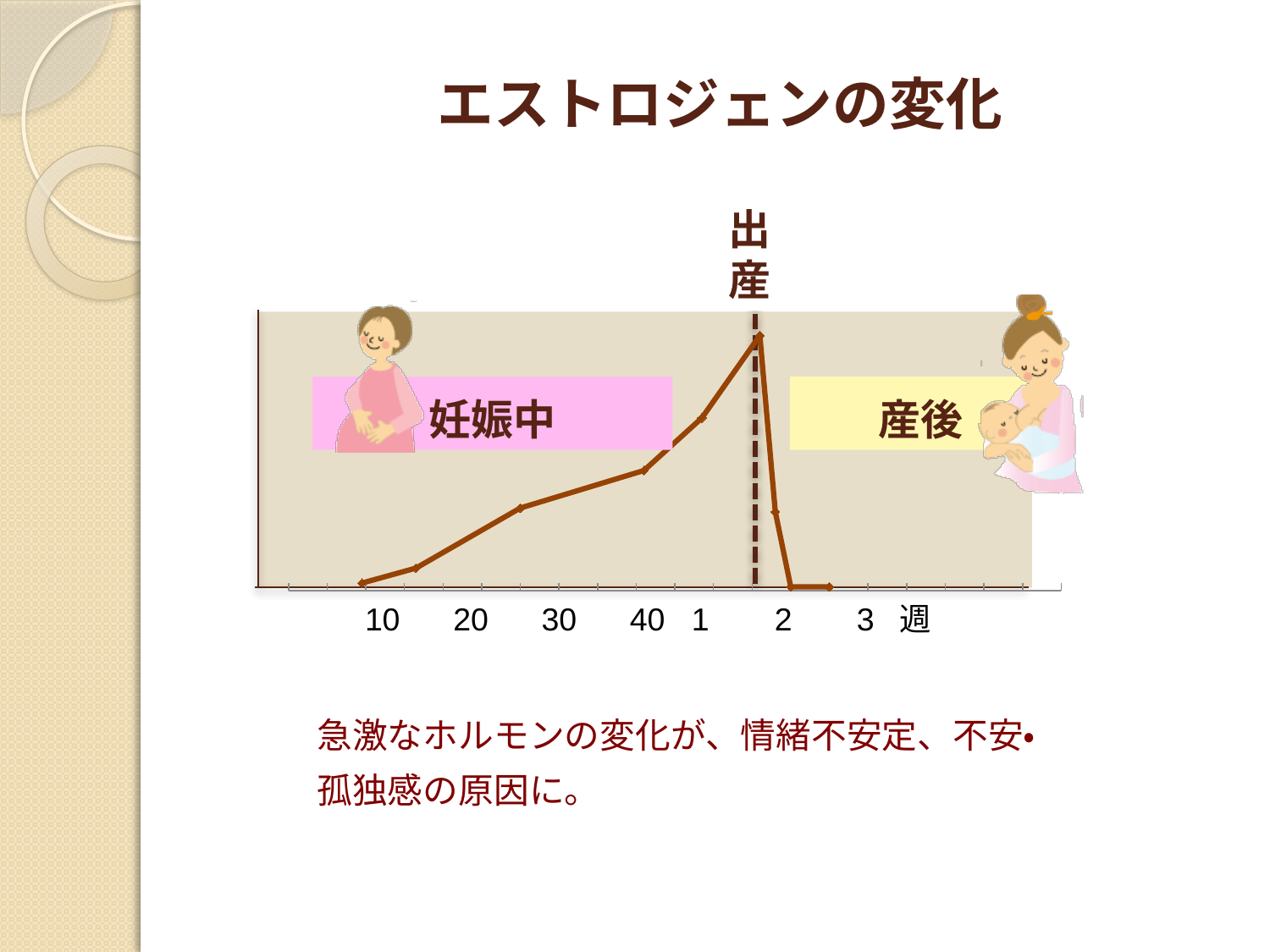
What kind of chart is shown on the slide? Line chart What unit is shown at the end of the x axis? 週 Which is larger, the value at 出産 or the value at 3 weeks after birth? 出産 Does the line rise or fall from week 10 to 出産? Rise What is the title of the chart? エストロジェンの変化 Which is larger, the value at week 40 or the value at week 10? Week 40 How many data points are marked on the line? 9 How many data series are plotted on the chart? 1 Which is larger, the value at week 30 or the value at week 20? Week 30 At which point on the x axis does the line reach its highest value? 出産 Does the line rise or fall after 出産? Fall What are the two labelled periods shown on the chart? 妊娠中 and 産後